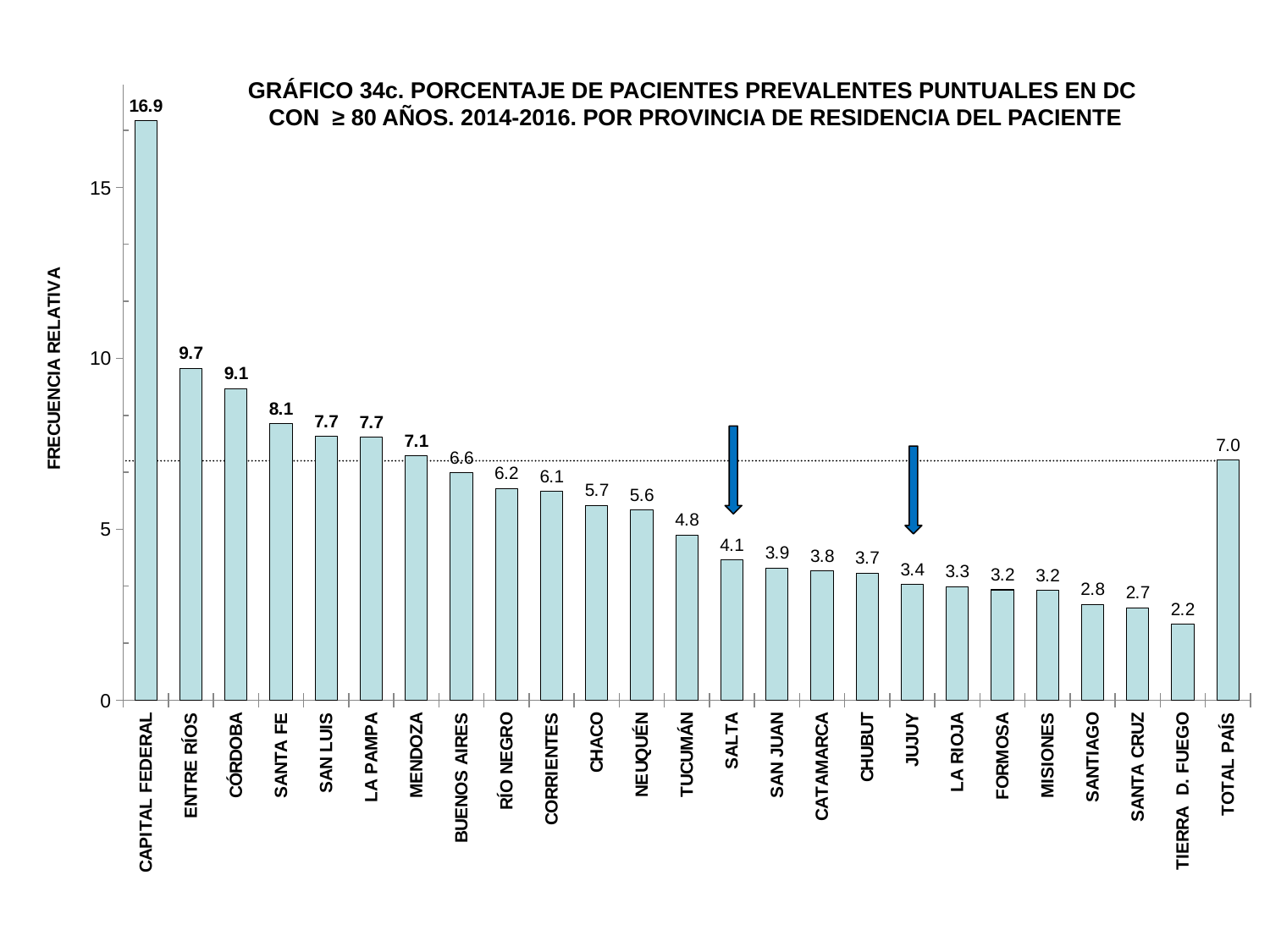
Is the value for SANTA FE greater or less than 5? greater What is the value for TOTAL PAÍS? 7.0 How many bars are shown in the chart? 25 Which is larger, the value for CHACO or the value for TUCUMÁN? CHACO Which province has the highest value? CAPITAL FEDERAL What is the label of the vertical axis? FRECUENCIA RELATIVA What kind of chart is shown on the slide? bar chart Which province has the lowest value? TIERRA D. FUEGO What is the value for SALTA? 4.1 What is the difference between the values for MENDOZA and BUENOS AIRES? 0.5 What is the value for CÓRDOBA? 9.1 What is the difference between the values for CAPITAL FEDERAL and ENTRE RÍOS? 7.2